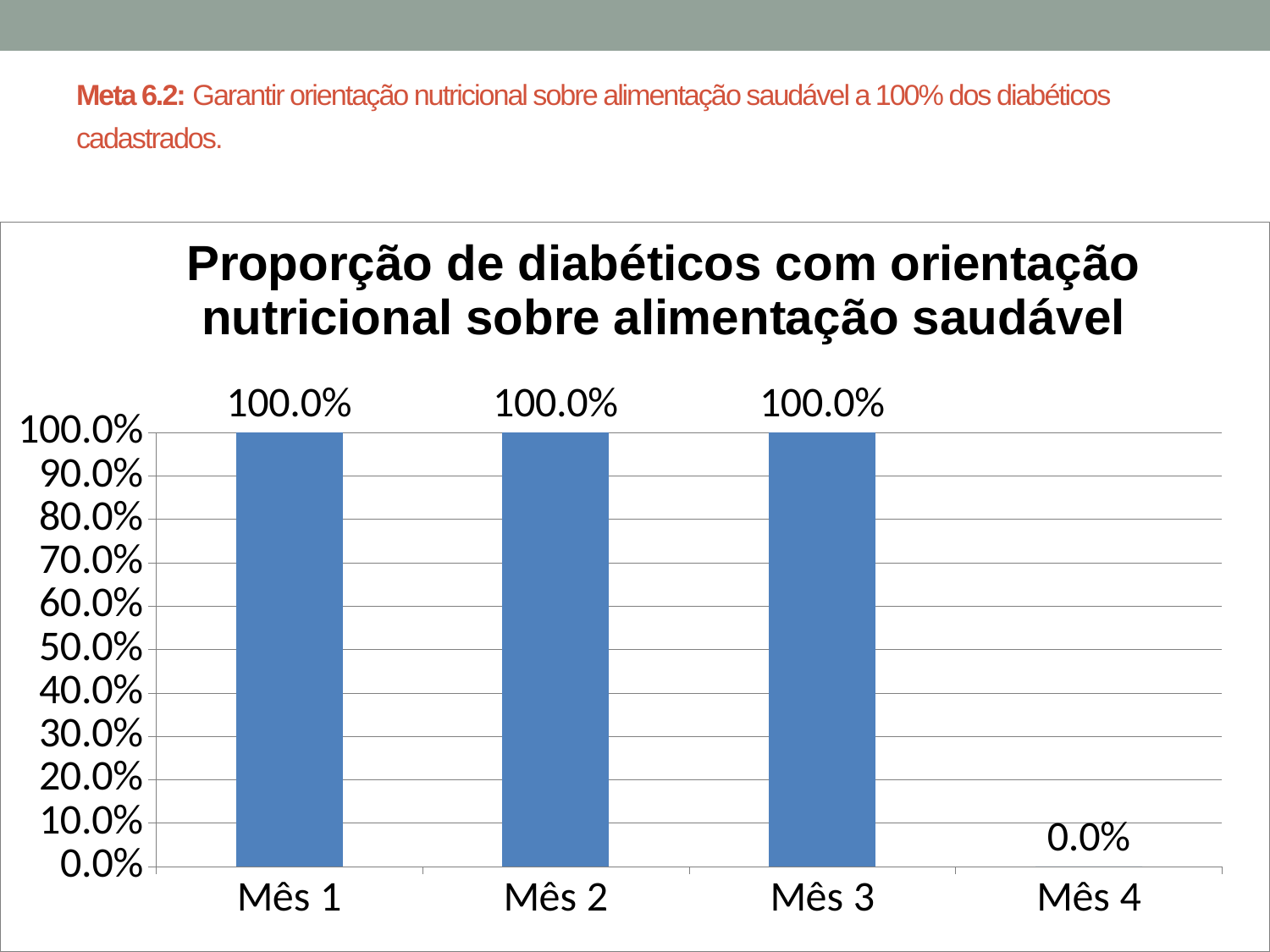
What is the value for Mês 3? 100.0% How many categories are shown on the x axis? 4 Which category has the lowest value? Mês 4 Do the values rise or fall from Mês 3 to Mês 4? fall What kind of chart is shown on the slide? bar chart Which is larger, the value for Mês 3 or the value for Mês 4? Mês 3 What colour are the bars in the chart? blue Is the value for Mês 2 greater or less than 50.0%? greater What is the title of the chart? Proporção de diabéticos com orientação nutricional sobre alimentação saudável What is the value for Mês 4? 0.0% What is the difference between the values for Mês 2 and Mês 4? 100.0% What is the value for Mês 1? 100.0%